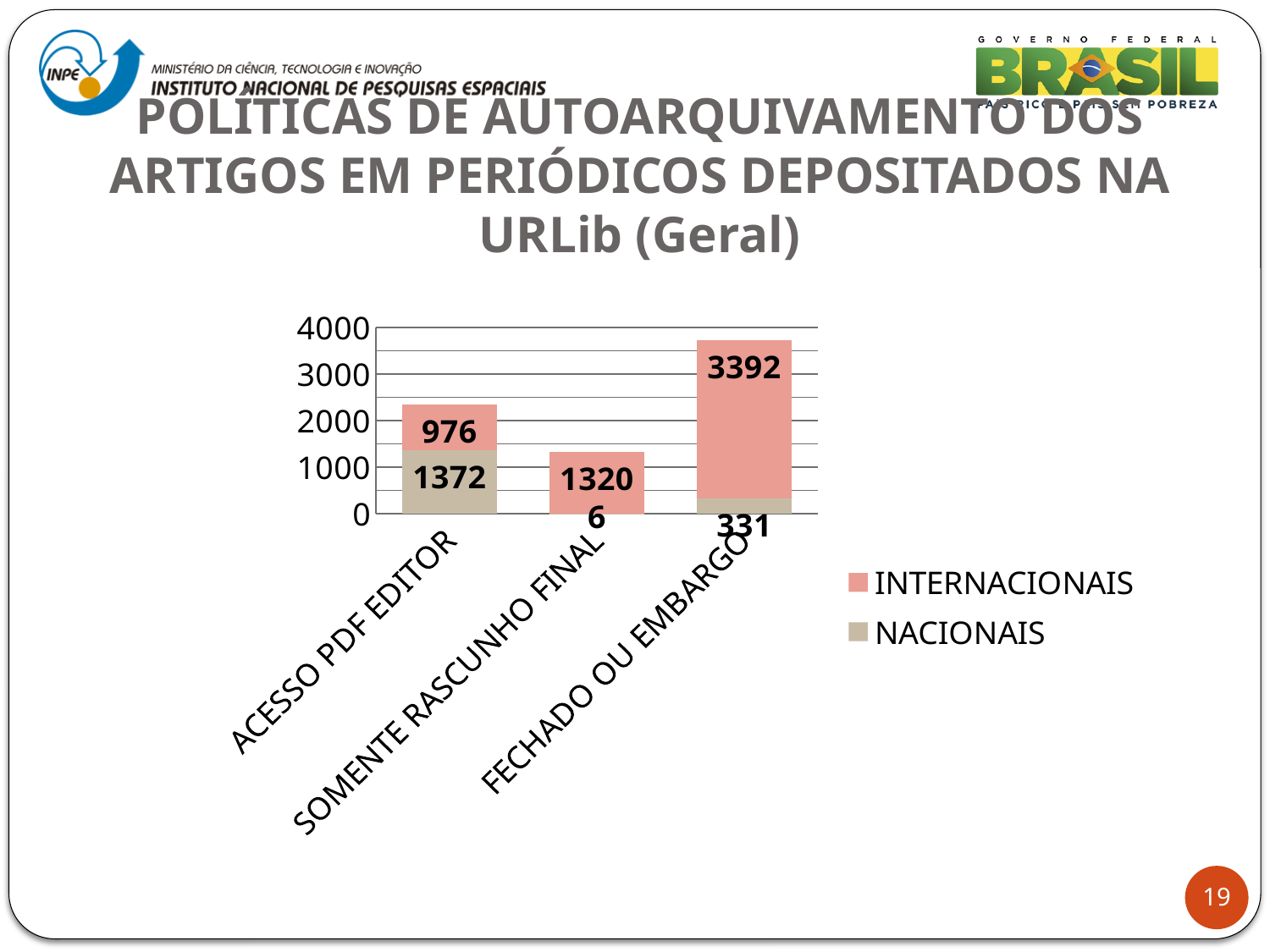
What is the INTERNACIONAIS value for FECHADO OU EMBARGO? 3392 What is the difference between the INTERNACIONAIS values for FECHADO OU EMBARGO and SOMENTE RASCUNHO FINAL? 2072 Which is larger for ACESSO PDF EDITOR, the NACIONAIS value or the INTERNACIONAIS value? NACIONAIS Which category has the lowest NACIONAIS value? SOMENTE RASCUNHO FINAL Which category has the highest INTERNACIONAIS value? FECHADO OU EMBARGO What is the NACIONAIS value for ACESSO PDF EDITOR? 1372 How many categories are shown on the x axis? 3 What kind of chart is shown on the slide? Stacked bar chart What is the total of the stacked bar for FECHADO OU EMBARGO? 3723 What is the NACIONAIS value for SOMENTE RASCUNHO FINAL? 6 What is the INTERNACIONAIS value for ACESSO PDF EDITOR? 976 How many series does the legend list? 2